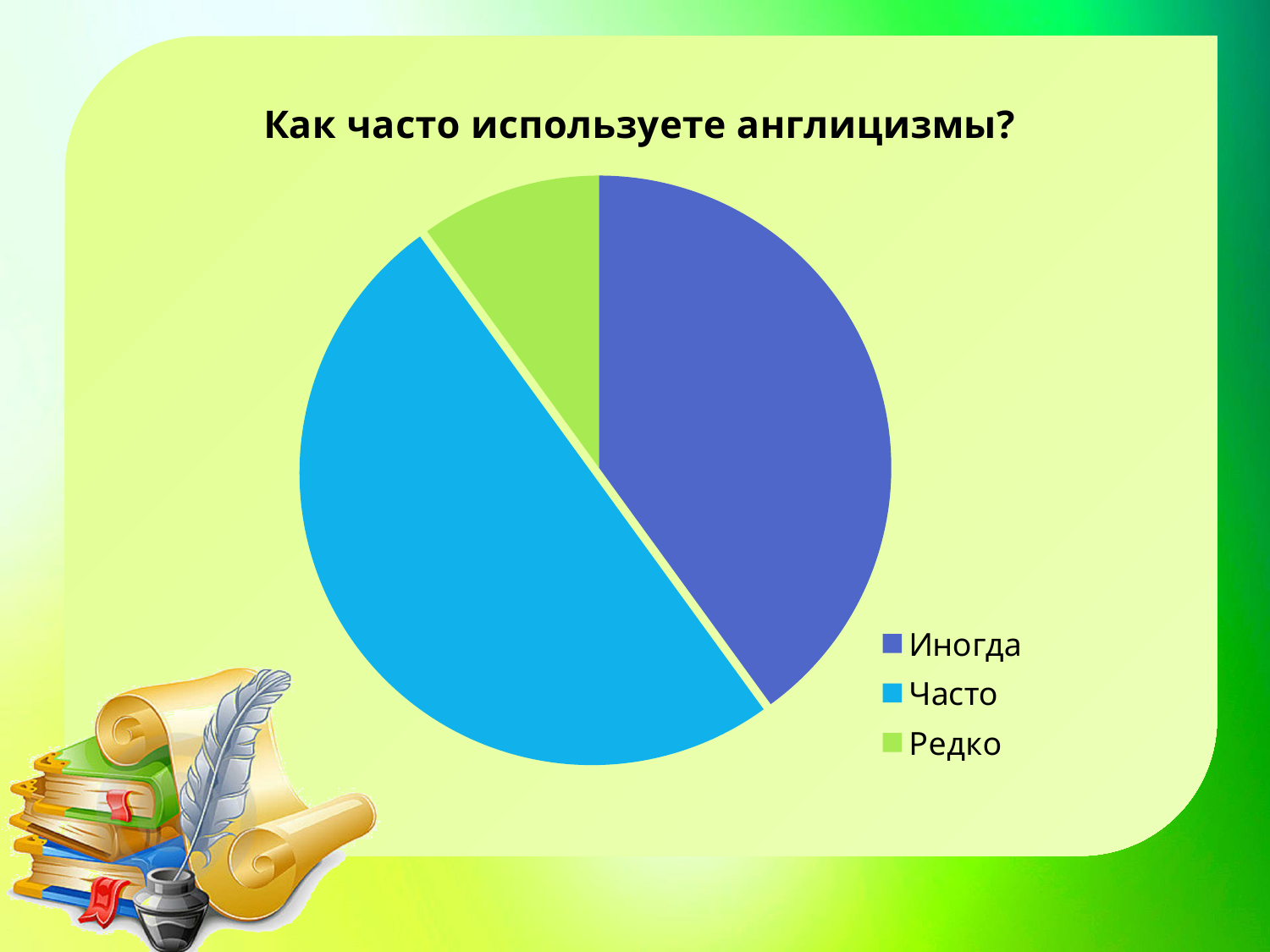
How many slices does the pie chart have? 3 What kind of chart is shown on the slide? pie chart What is the title of the chart? Как часто используете англицизмы? Which slice is larger, Иногда or Редко? Иногда Which category has the smallest slice of the pie? Редко Which slice is larger, Часто or Редко? Часто How many entries does the legend list? 3 Which category has the largest slice of the pie? Часто What colour is the slice for Редко? green